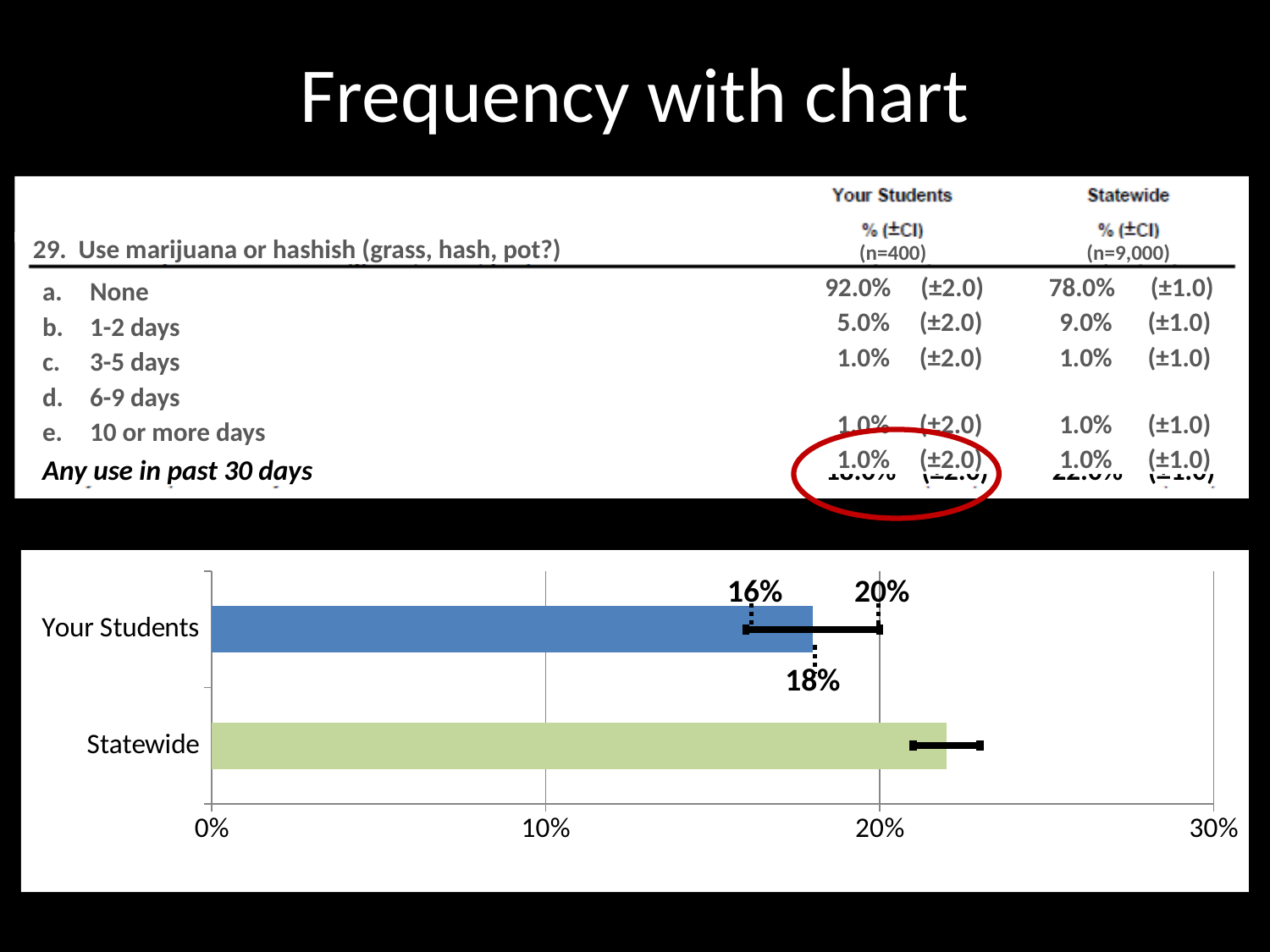
What is the value for Your Students in the bar chart? 18% What are the lower and upper ends of the error bar labelled for Your Students? 16% and 20% What kind of chart is shown on the slide? bar chart Is the value for Your Students greater or less than 20%? less How many categories does the bar chart show? 2 Which category has the higher value, Your Students or Statewide? Statewide Is the value for Statewide greater or less than 20%? greater Which category has the lowest value in the bar chart? Your Students What is the highest value shown on the x axis of the bar chart? 30% Which category has the highest value in the bar chart? Statewide